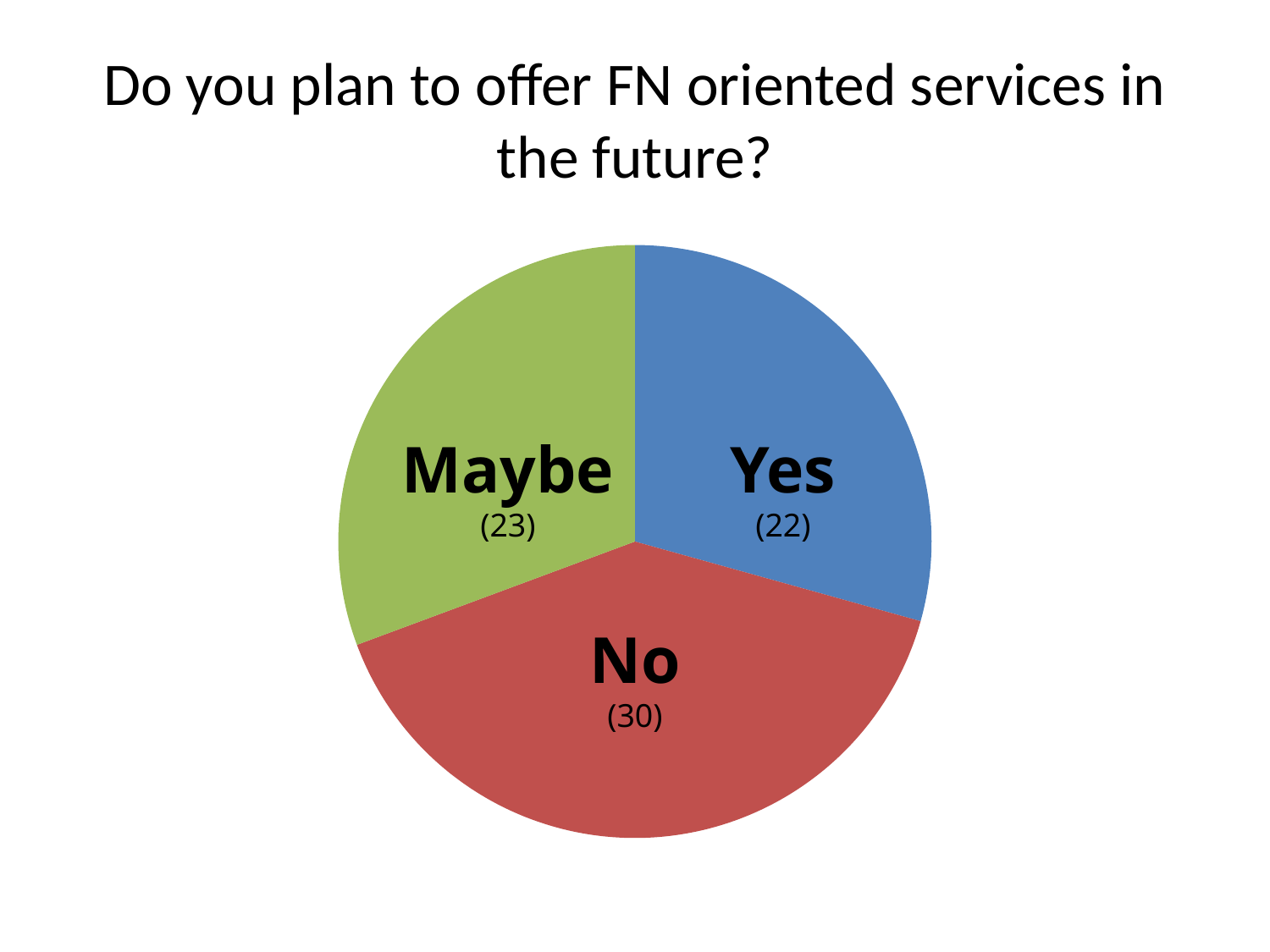
What is the value shown for the "Maybe" slice? 23 What kind of chart is shown on the slide? Pie chart Which response has the smallest slice of the pie? Yes Which is larger, the value for "No" or the value for "Maybe"? No What share of the pie does the "No" slice represent? 40% What is the value shown for the "Yes" slice? 22 What is the difference between the "No" value and the "Yes" value? 8 What colour is the "No" slice? Red What is the difference between the "No" value and the "Maybe" value? 7 Which response has the largest slice of the pie? No What is the value shown for the "No" slice? 30 How many slices does the pie chart have? 3